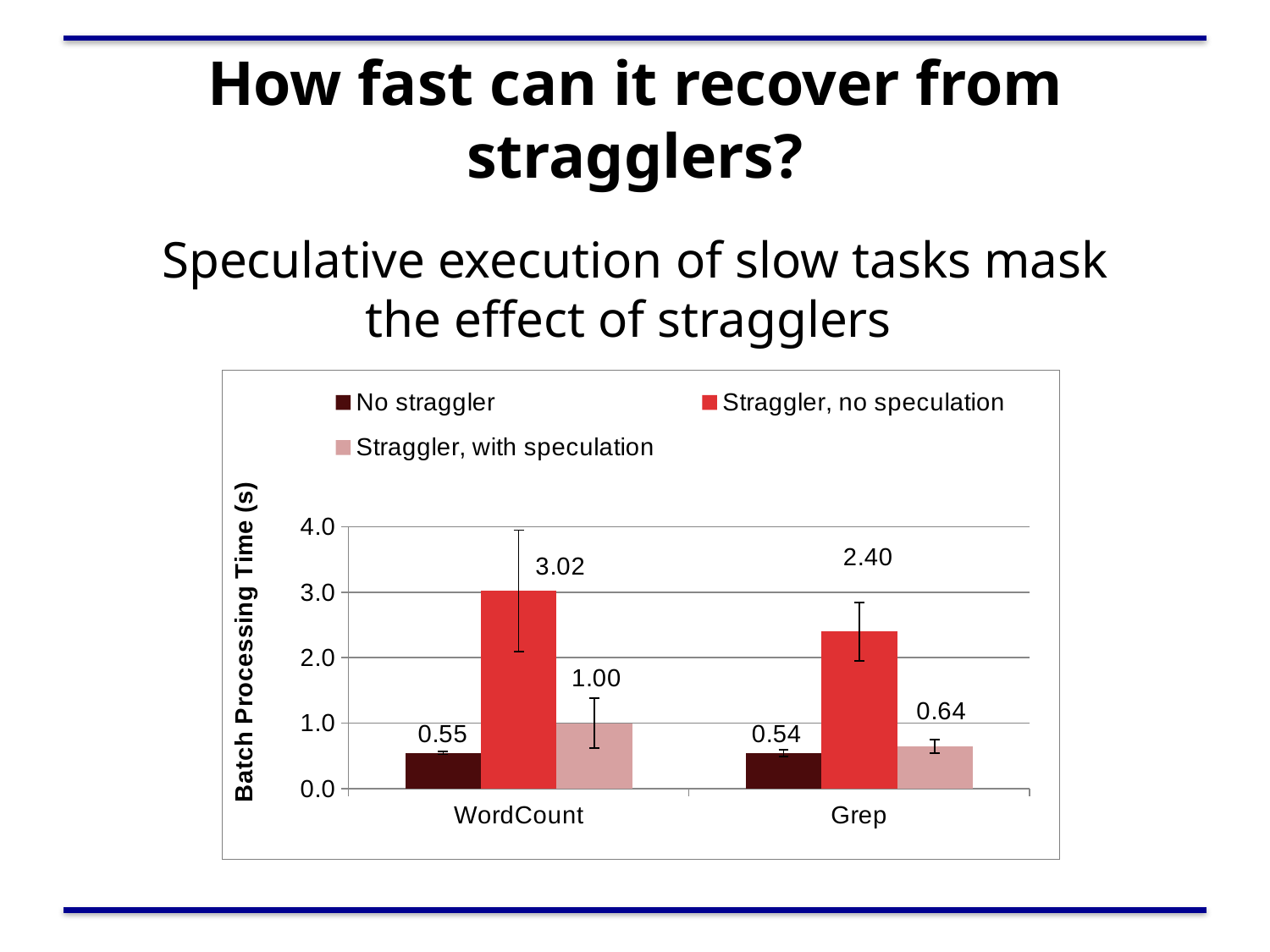
How many categories are shown on the x axis? 2 Which series has the lowest batch processing time for Grep? No straggler Which is larger: the 'Straggler, no speculation' value for WordCount or for Grep? WordCount What is the batch processing time for WordCount with a straggler and no speculation? 3.02 What is the batch processing time for WordCount with no straggler? 0.55 Which series has the highest batch processing time for WordCount? Straggler, no speculation What type of chart is shown on the slide? Bar chart How many series does the legend list? 3 Is the 'Straggler, no speculation' value for Grep greater or less than 2.0? greater What is the difference between the 'Straggler, no speculation' and 'Straggler, with speculation' values for WordCount? 2.02 What is the batch processing time for Grep with a straggler and with speculation? 0.64 What is the batch processing time for Grep with a straggler and no speculation? 2.40